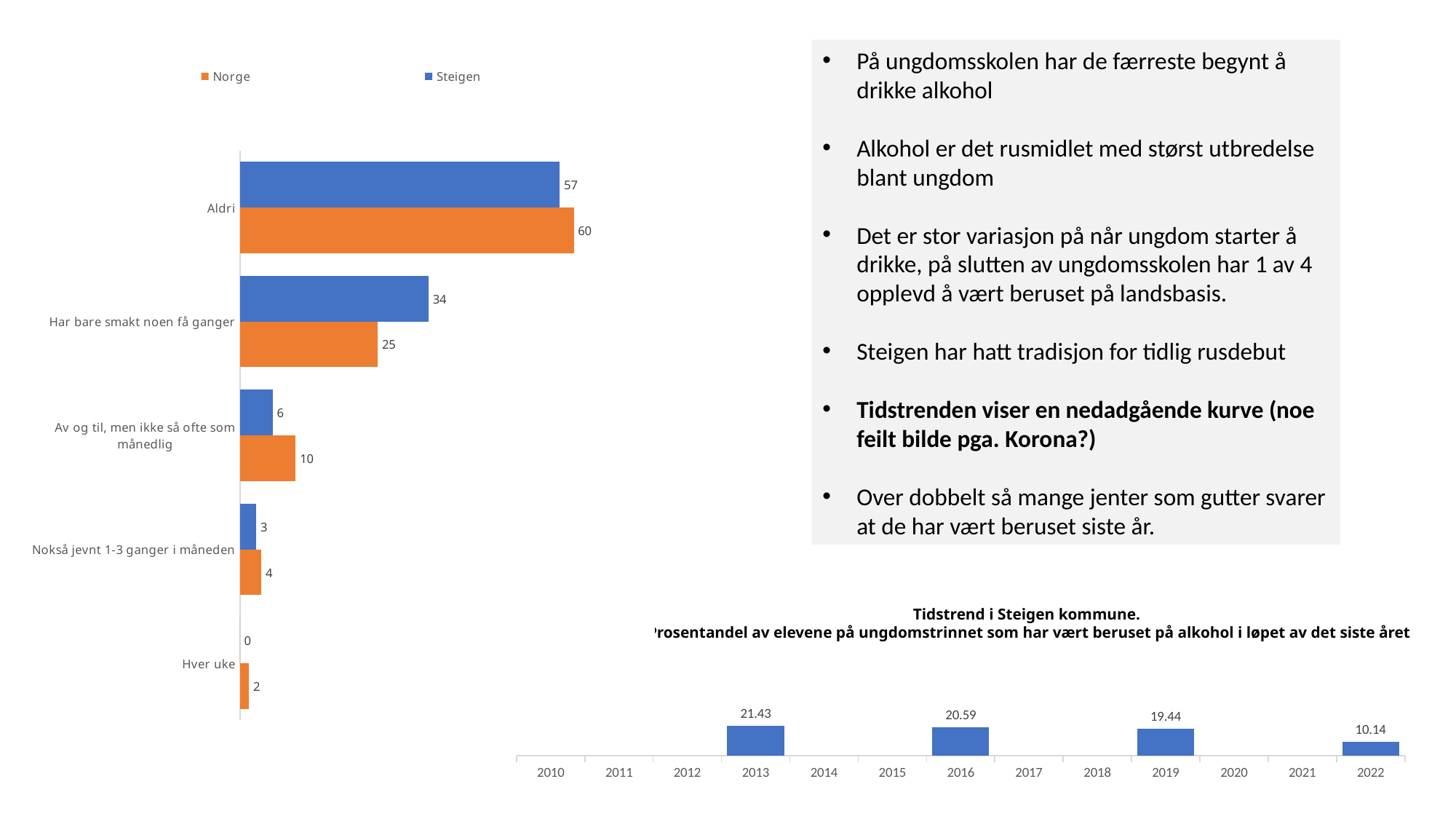
In the bar chart on the left, which is larger in the category 'Av og til, men ikke så ofte som månedlig': Norge or Steigen? Norge In the bar chart on the left, which category has the highest value for Norge? Aldri In the bar chart on the left, what is the value for Steigen in the category 'Aldri'? 57 In the chart 'Tidstrend i Steigen kommune', do the values rise or fall from 2013 to 2022? fall In the bar chart on the left, what is the value for Steigen in the category 'Hver uke'? 0 In the bar chart on the left, what is the value for Norge in the category 'Har bare smakt noen få ganger'? 25 How many series does the legend of the bar chart on the left list? 2 How many categories are shown in the bar chart on the left? 5 In the chart 'Tidstrend i Steigen kommune', which year has the lowest value? 2022 In the bar chart on the left, what is the difference between Norge and Steigen in the category 'Har bare smakt noen få ganger'? 9 In the chart 'Tidstrend i Steigen kommune', what is the value for 2016? 20.59 What kind of chart is 'Tidstrend i Steigen kommune'? bar chart